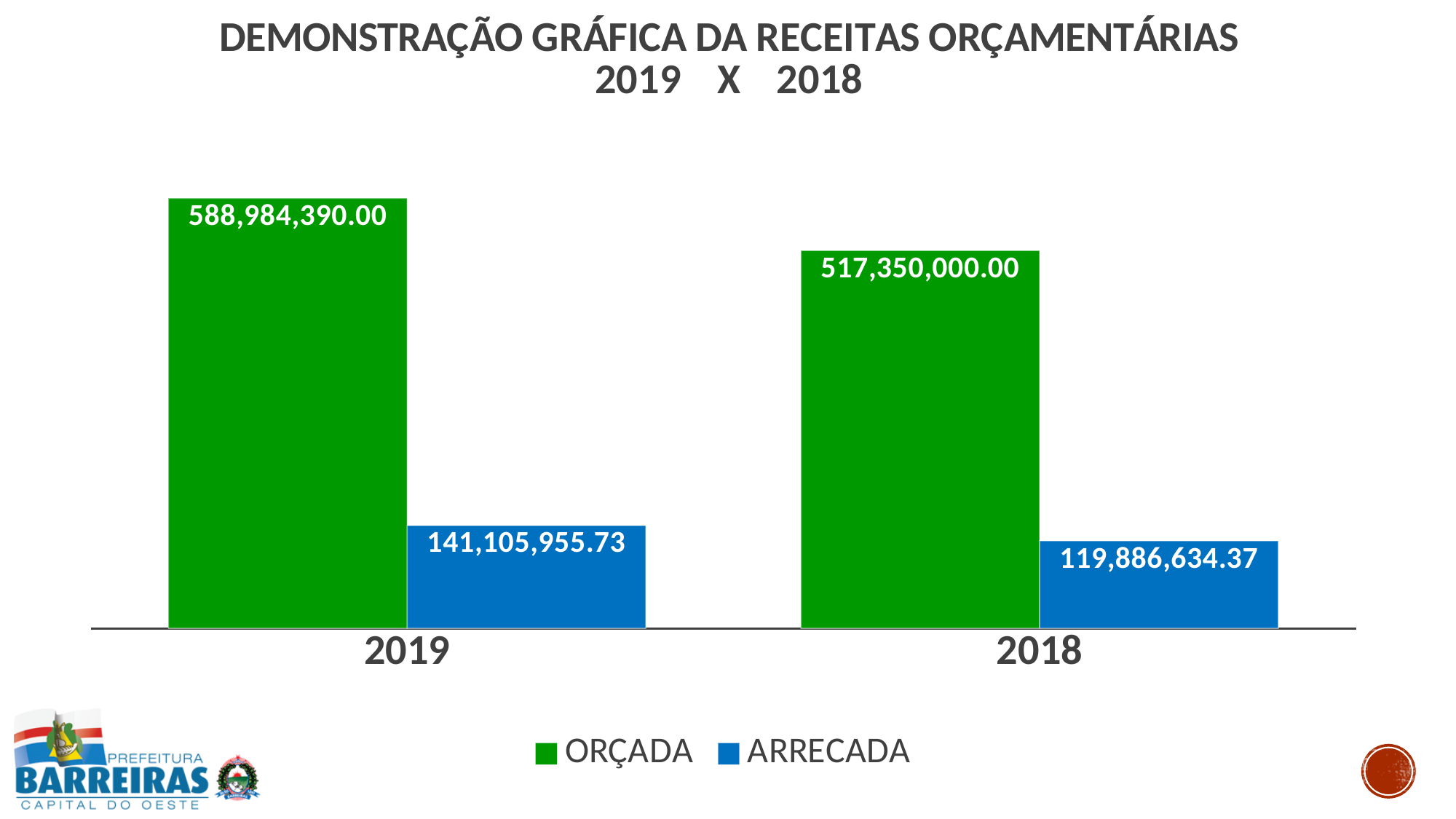
What kind of chart is shown on the slide? bar chart Is the ARRECADA value for 2019 larger or smaller than the ARRECADA value for 2018? larger Which bar has the lowest value on the chart? ARRECADA for 2018 What is the ORÇADA value for 2019? 588,984,390.00 How many years (categories) are shown on the x axis? 2 What is the difference between the ARRECADA values for 2019 and 2018? 21,219,321.36 What is the difference between the ORÇADA values for 2019 and 2018? 71,634,390.00 What is the ARRECADA value for 2019? 141,105,955.73 Which year has the higher ORÇADA value? 2019 How many series does the legend list? 2 What is the ARRECADA value for 2018? 119,886,634.37 What is the ORÇADA value for 2018? 517,350,000.00